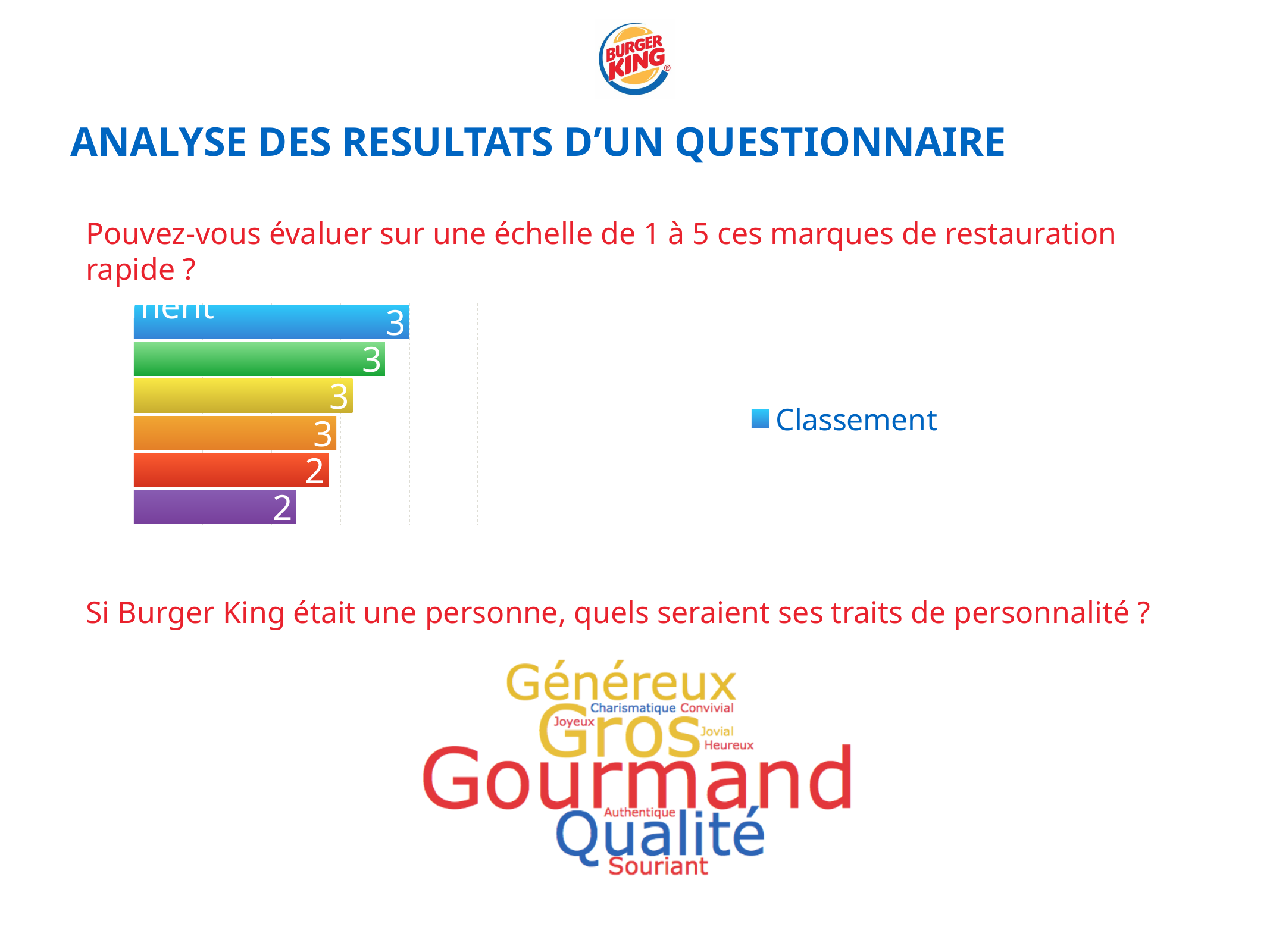
How many bars does the bar chart contain? 6 What is the value of the bottom (purple) bar in the bar chart? 2 Do the bar values increase or decrease going from the top bar to the bottom bar? decrease How many series does the legend of the bar chart list? 1 What is the value of the top (blue) bar in the bar chart? 3 What is the value of the orange bar in the bar chart? 3 What is the difference between the value of the blue bar and the value of the purple bar? 1 How many bars in the bar chart have a value of 3? 4 What is the value of the red bar in the bar chart? 2 What kind of chart is shown on the slide? bar chart Which bar has the larger value, the green bar or the red bar? green bar What is the name of the series shown in the legend of the bar chart? Classement